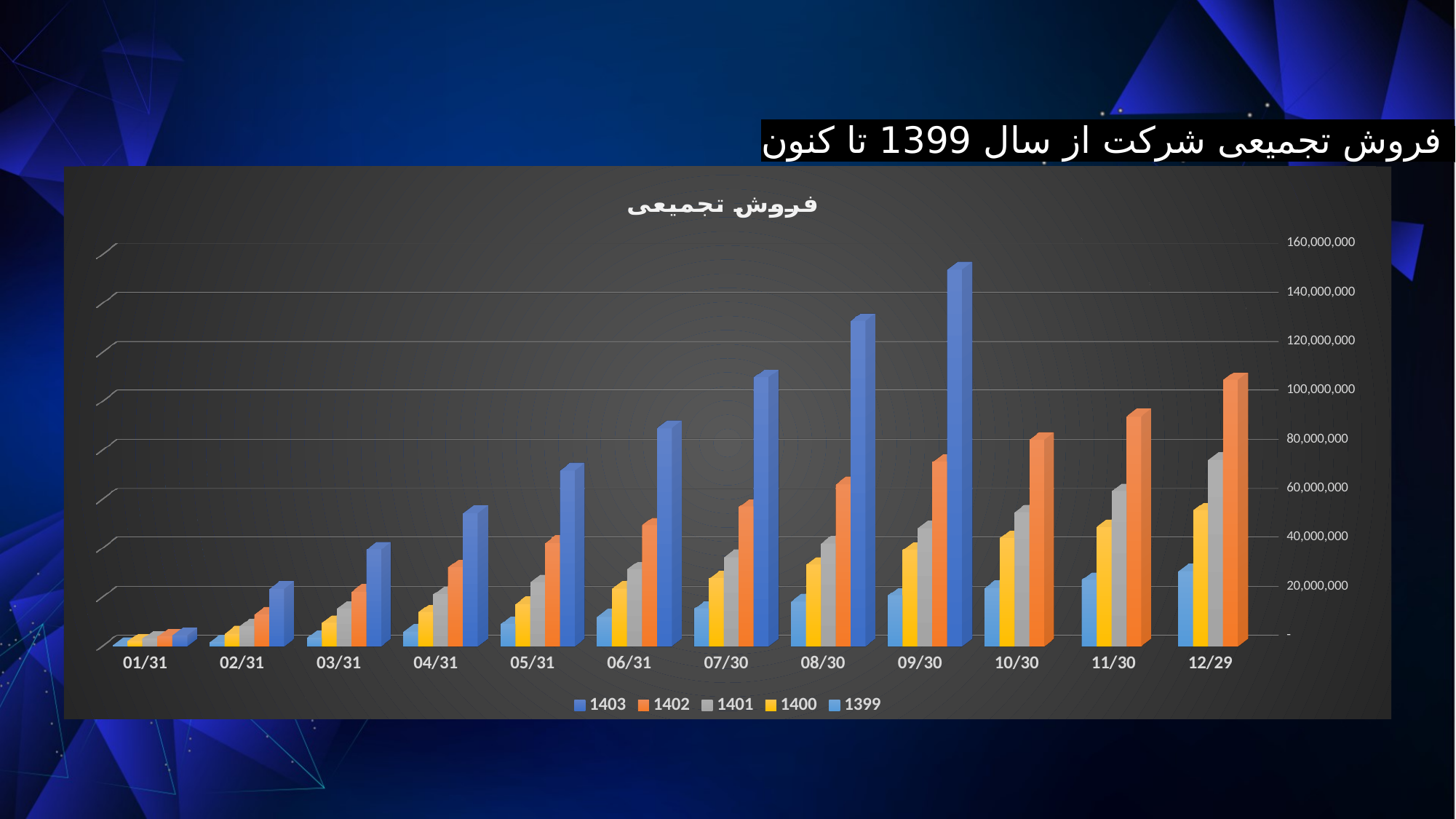
Is the value for 1403 at 09/30 greater or less than 120,000,000? greater How many categories are shown along the x axis? 12 At which category does the 1403 series reach its highest value? 09/30 What kind of chart is shown on the slide? bar chart Do the values for the 1403 series rise or fall from 01/31 to 09/30? rise Is the value for 1399 at 12/29 greater or less than 40,000,000? less Is the value for 1402 at 12/29 greater or less than 80,000,000? greater Which is larger at 12/29, the value for 1402 or the value for 1401? 1402 What is the title of the chart? فروش تجمیعی Which series is listed first in the legend? 1403 How many series does the legend list? 5 At which category is the 1402 series lowest? 01/31